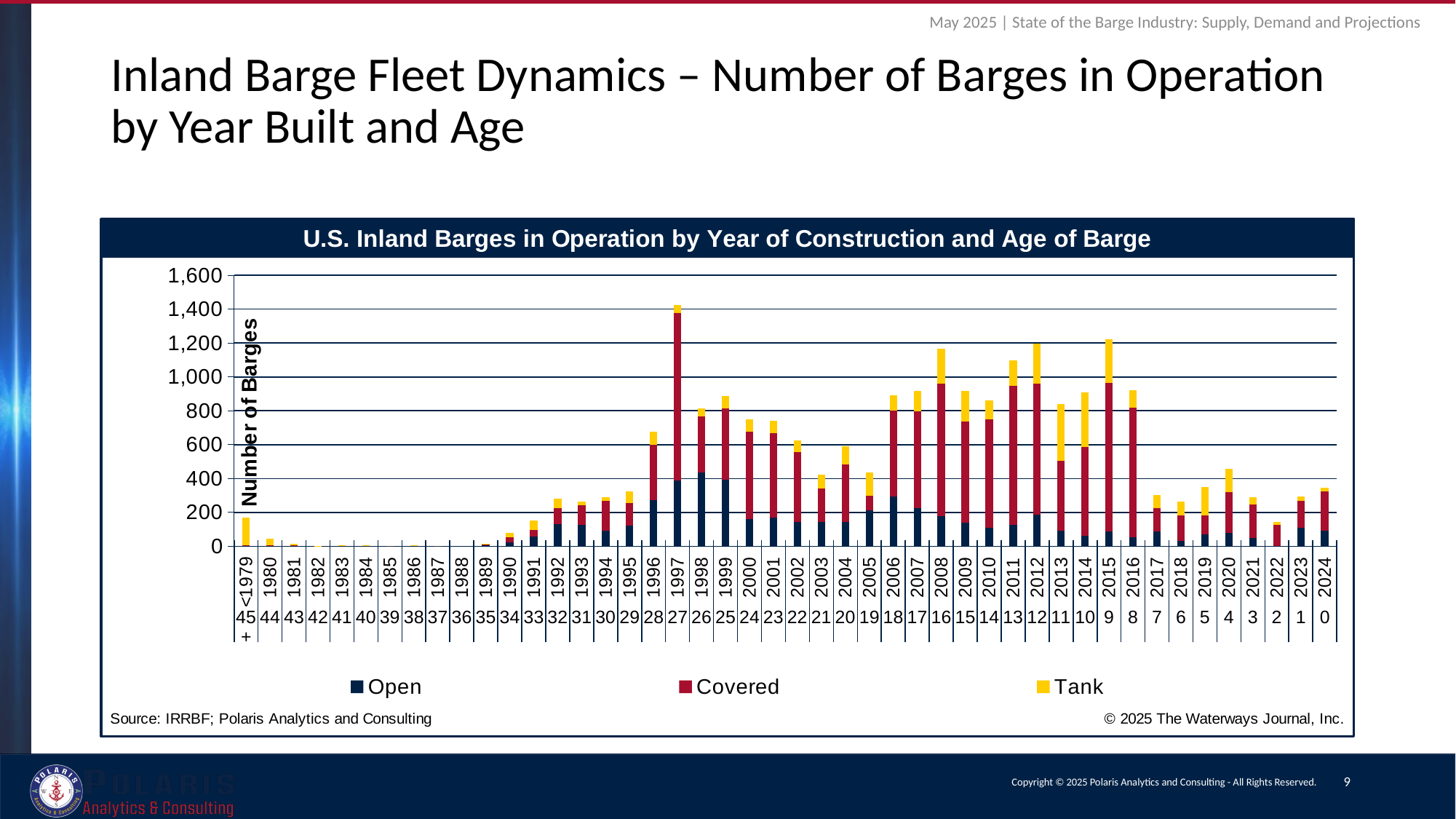
What kind of chart is shown on the slide? Stacked bar chart Is the total number of barges built in 1997 greater or less than 1,200? greater Is the total number of barges built in 2008 greater or less than 1,000? greater What are the three series named in the legend? Open, Covered, Tank Which has a larger total number of barges in operation, 1997 or 2015? 1997 What is the label on the vertical axis? Number of Barges Is the total number of barges built in 2022 greater or less than 200? less Which year of construction has the highest total number of barges in operation? 1997 How many series does the legend list? 3 How many year-built categories are shown along the x axis? 46 Which has a larger total number of barges in operation, 2019 or 2020? 2020